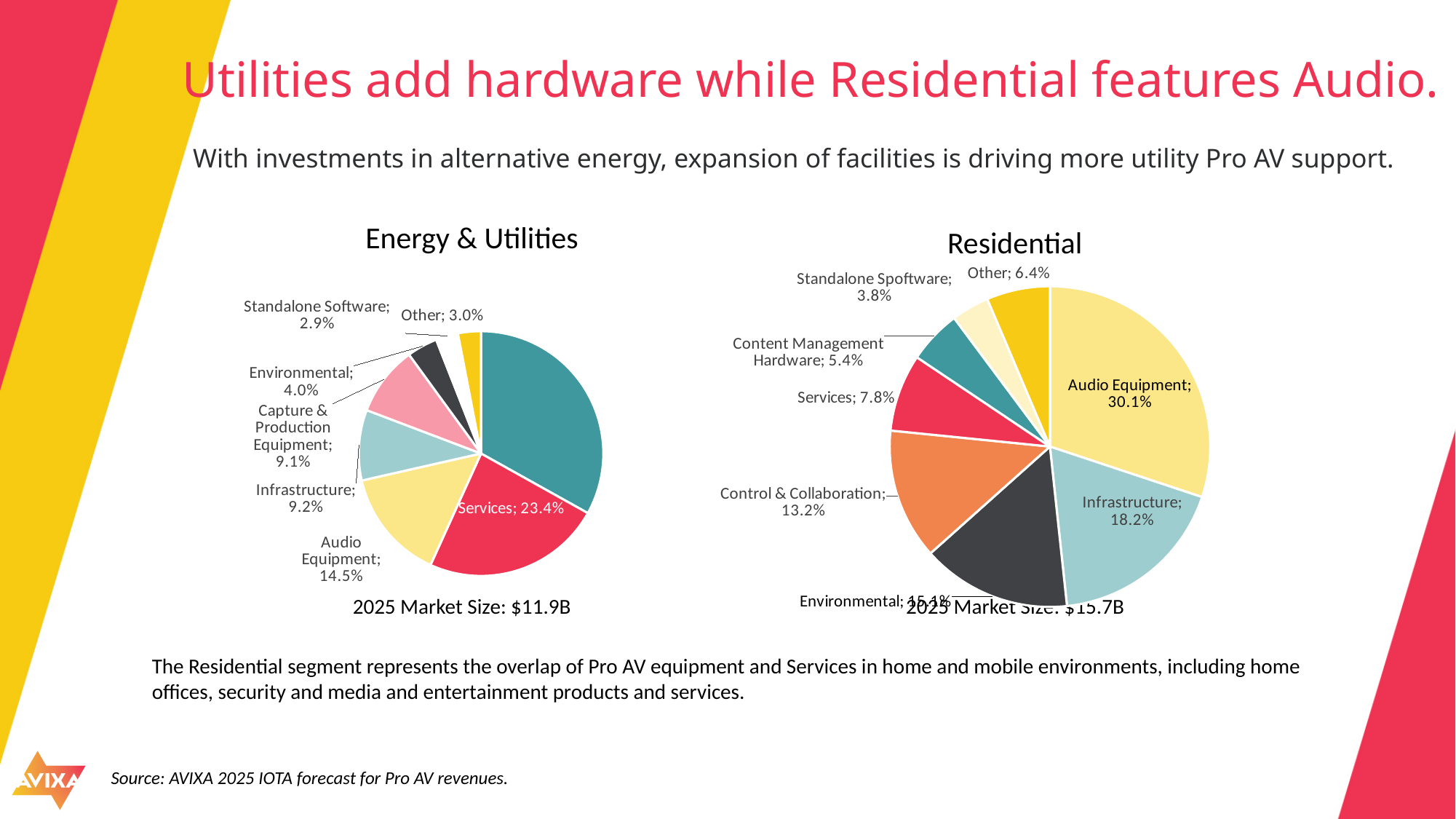
What 2025 market size is shown beneath the Energy & Utilities pie chart? $11.9B In the Residential pie chart, which category has the smallest share? Standalone Spoftware What type of chart is used for the Energy & Utilities data? Pie chart In the Energy & Utilities pie chart, what share does Services hold? 23.4% In the Energy & Utilities pie chart, what is the share for Capture & Production Equipment? 9.1% Is the Services share larger in the Energy & Utilities chart or in the Residential chart? Energy & Utilities In the Residential pie chart, which category has the largest share? Audio Equipment In the Residential pie chart, how many percentage points larger is Audio Equipment than Infrastructure? 11.9 percentage points How many slices does the Residential pie chart have? 8 In the Residential pie chart, what share does Audio Equipment hold? 30.1% In the Energy & Utilities pie chart, what is the share for Audio Equipment? 14.5% In the Residential pie chart, what is the share for Control & Collaboration? 13.2%